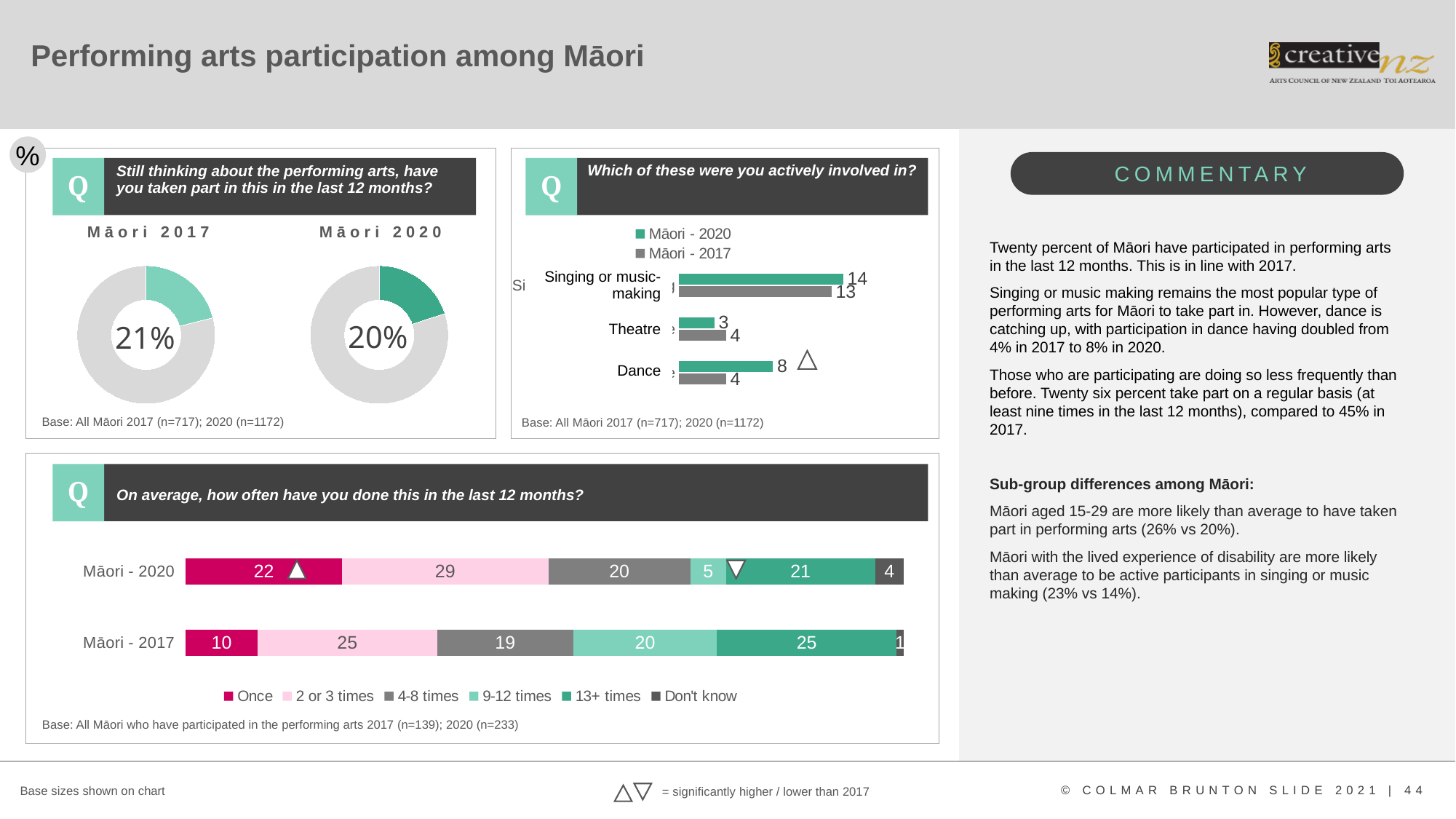
In the donut chart for Māori 2017 under 'Still thinking about the performing arts, have you taken part in this in the last 12 months?', what percentage is shown? 21% In the chart 'On average, how often have you done this in the last 12 months?', what is the value for 'Once' for Māori - 2020? 22 In the donut chart for Māori 2020 under 'Still thinking about the performing arts, have you taken part in this in the last 12 months?', what percentage is shown? 20% In the chart 'Which of these were you actively involved in?', what is the difference between the Māori - 2020 and Māori - 2017 values for Dance? 4 In the chart 'On average, how often have you done this in the last 12 months?', what is the value for '9-12 times' for Māori - 2017? 20 In the chart 'Which of these were you actively involved in?', how many categories are shown? 3 In the chart 'Which of these were you actively involved in?', how many series does the legend list? 2 In the chart 'Which of these were you actively involved in?', what is the value for Dance for Māori - 2017? 4 In the chart 'Which of these were you actively involved in?', what is the value for Singing or music-making for Māori - 2020? 14 What kind of chart is 'On average, how often have you done this in the last 12 months?' Stacked bar chart In the chart 'On average, how often have you done this in the last 12 months?', which is larger: the '13+ times' value for Māori - 2020 or for Māori - 2017? Māori - 2017 In the chart 'Which of these were you actively involved in?', which category has the highest value for Māori - 2020? Singing or music-making